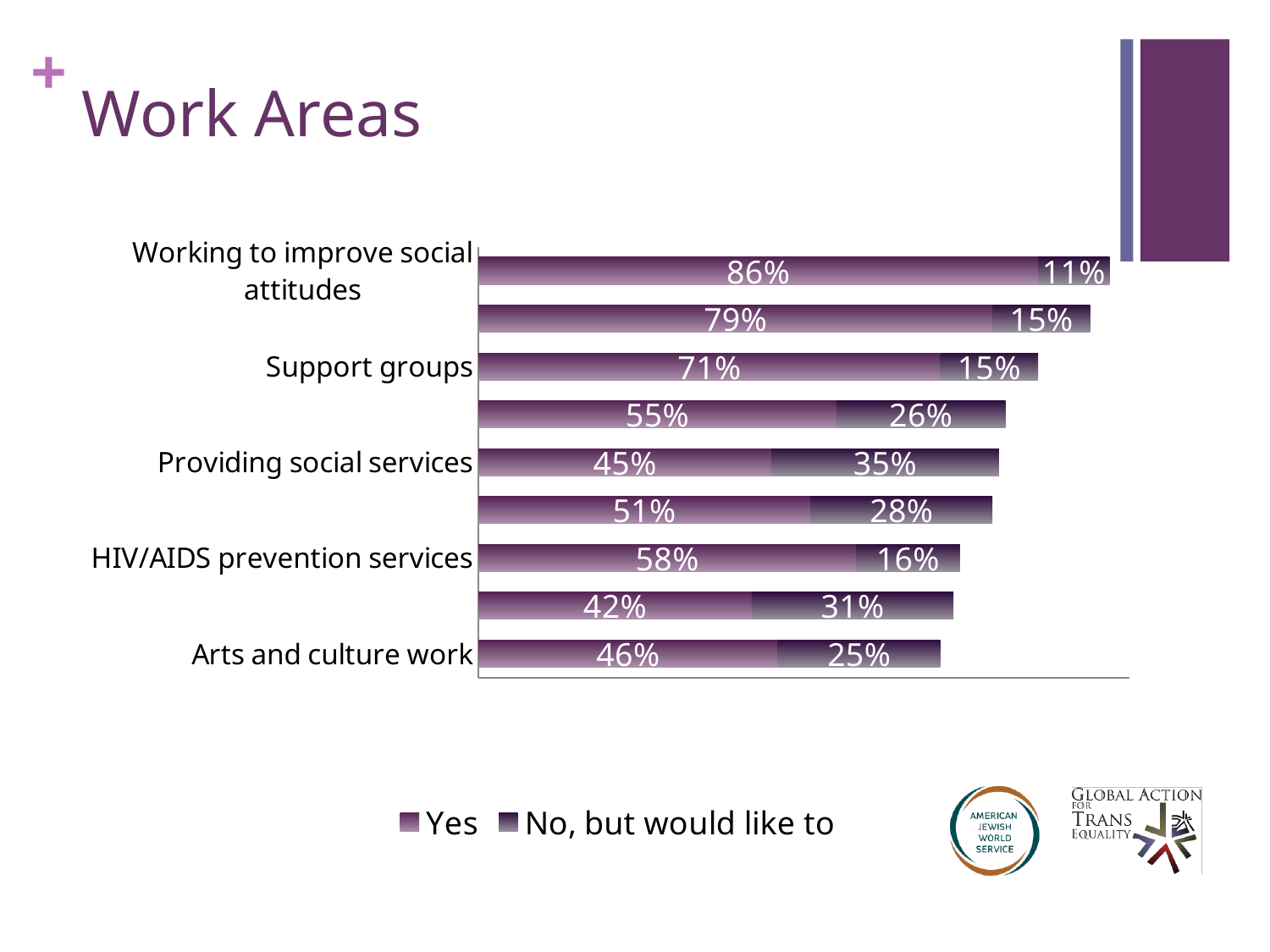
What is the combined total of the 'Yes' and 'No, but would like to' segments for Working to improve social attitudes? 97% What are the two legend entries of the chart? Yes; No, but would like to What is the 'Yes' value for Working to improve social attitudes? 86% Which has a larger 'Yes' value: Support groups or HIV/AIDS prevention services? Support groups What is the 'No, but would like to' value for Providing social services? 35% For HIV/AIDS prevention services, what is the difference between the 'Yes' value and the 'No, but would like to' value? 42% What kind of chart is shown on the slide? Stacked bar chart What is the 'No, but would like to' value for Arts and culture work? 25% What is the 'Yes' value for Support groups? 71% Which work area has the highest 'Yes' value? Working to improve social attitudes Which work area has the lowest 'No, but would like to' value? Working to improve social attitudes How many series does the legend list? 2